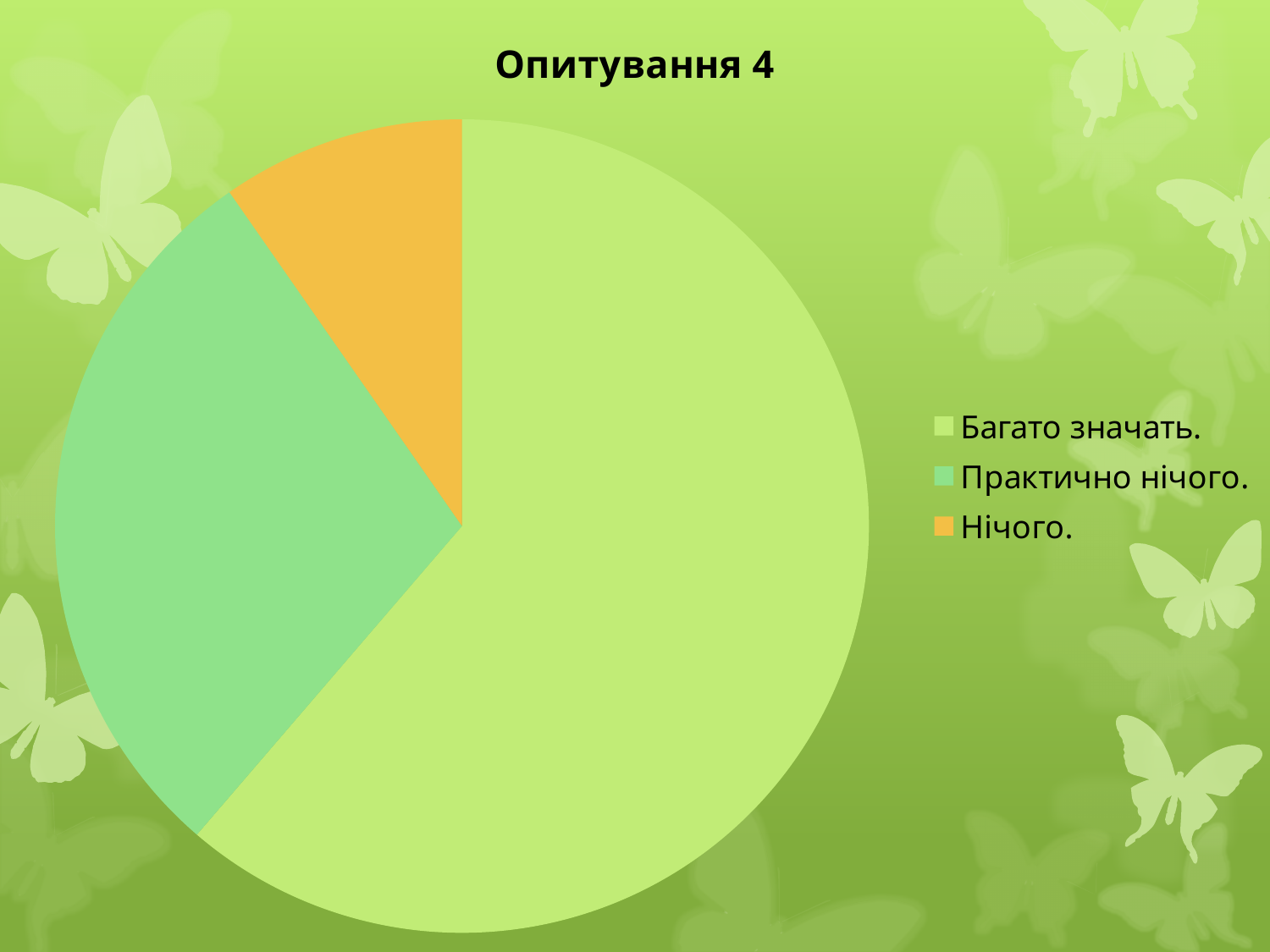
Which slice is larger: "Багато значать." or "Практично нічого."? Багато значать. Which slice is larger: "Практично нічого." or "Нічого."? Практично нічого. What is the title of the chart? Опитування 4 Does the "Багато значать." slice take up more or less than half of the pie? more Which category has the largest slice of the pie? Багато значать. What colour is the slice for "Нічого."? orange How many slices does the pie chart have? 3 How many entries does the legend list? 3 Which category has the smallest slice of the pie? Нічого. What kind of chart is shown on the slide? pie chart